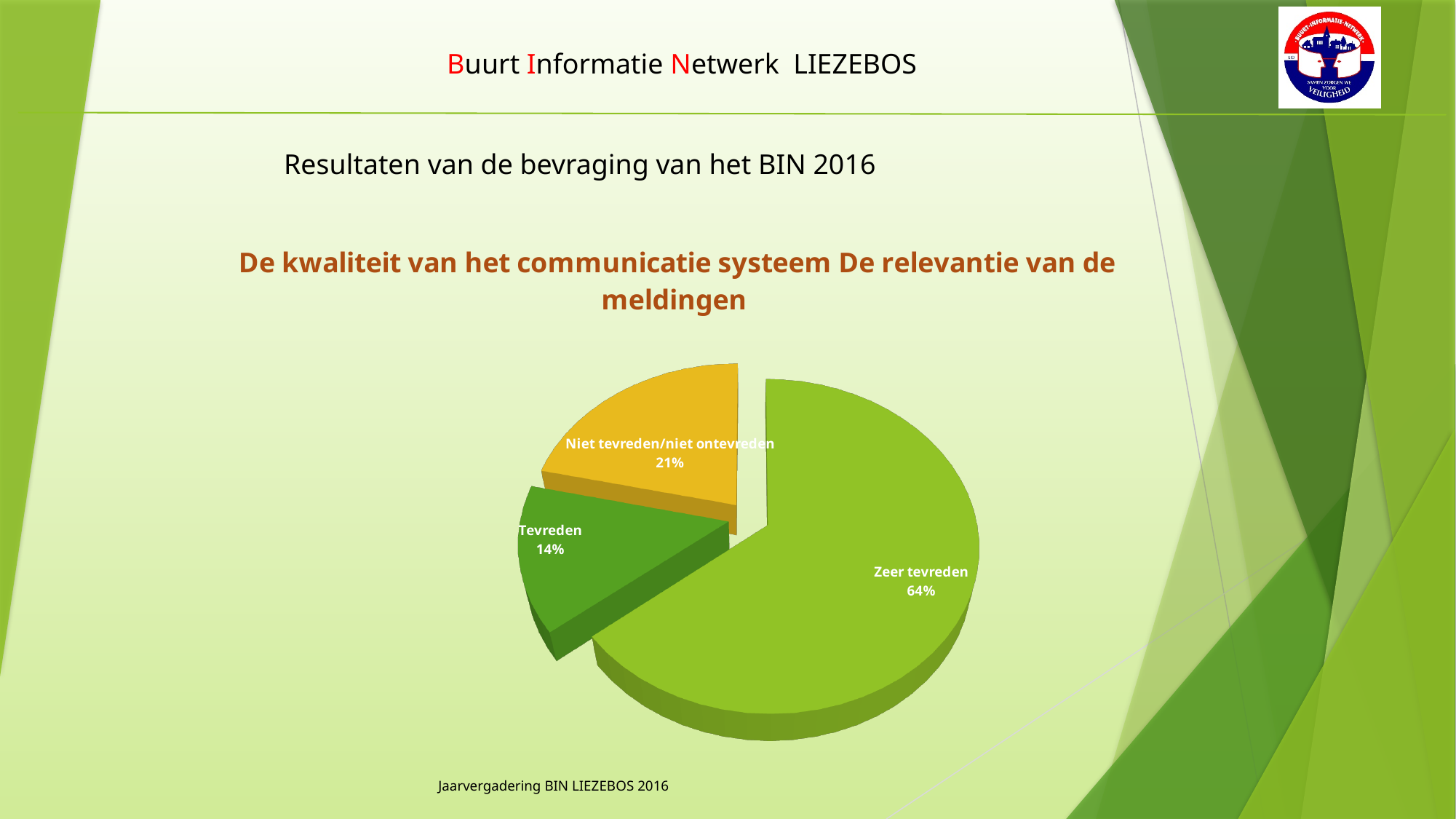
What percentage of the pie is labelled "Niet tevreden/niet ontevreden"? 21% What percentage of the pie is labelled "Zeer tevreden"? 64% Which is larger: the share for "Tevreden" or the share for "Niet tevreden/niet ontevreden"? Niet tevreden/niet ontevreden How many slices does the pie chart have? 3 What is the difference in percentage points between "Niet tevreden/niet ontevreden" and "Tevreden"? 7 What percentage of the pie is labelled "Tevreden"? 14% What is the difference in percentage points between "Zeer tevreden" and "Niet tevreden/niet ontevreden"? 43 Which category has the smallest share of the pie? Tevreden What is the title of the chart? De kwaliteit van het communicatie systeem De relevantie van de meldingen What kind of chart is shown on the slide? Pie chart What colour is the "Niet tevreden/niet ontevreden" slice? Yellow Which category has the largest share of the pie? Zeer tevreden